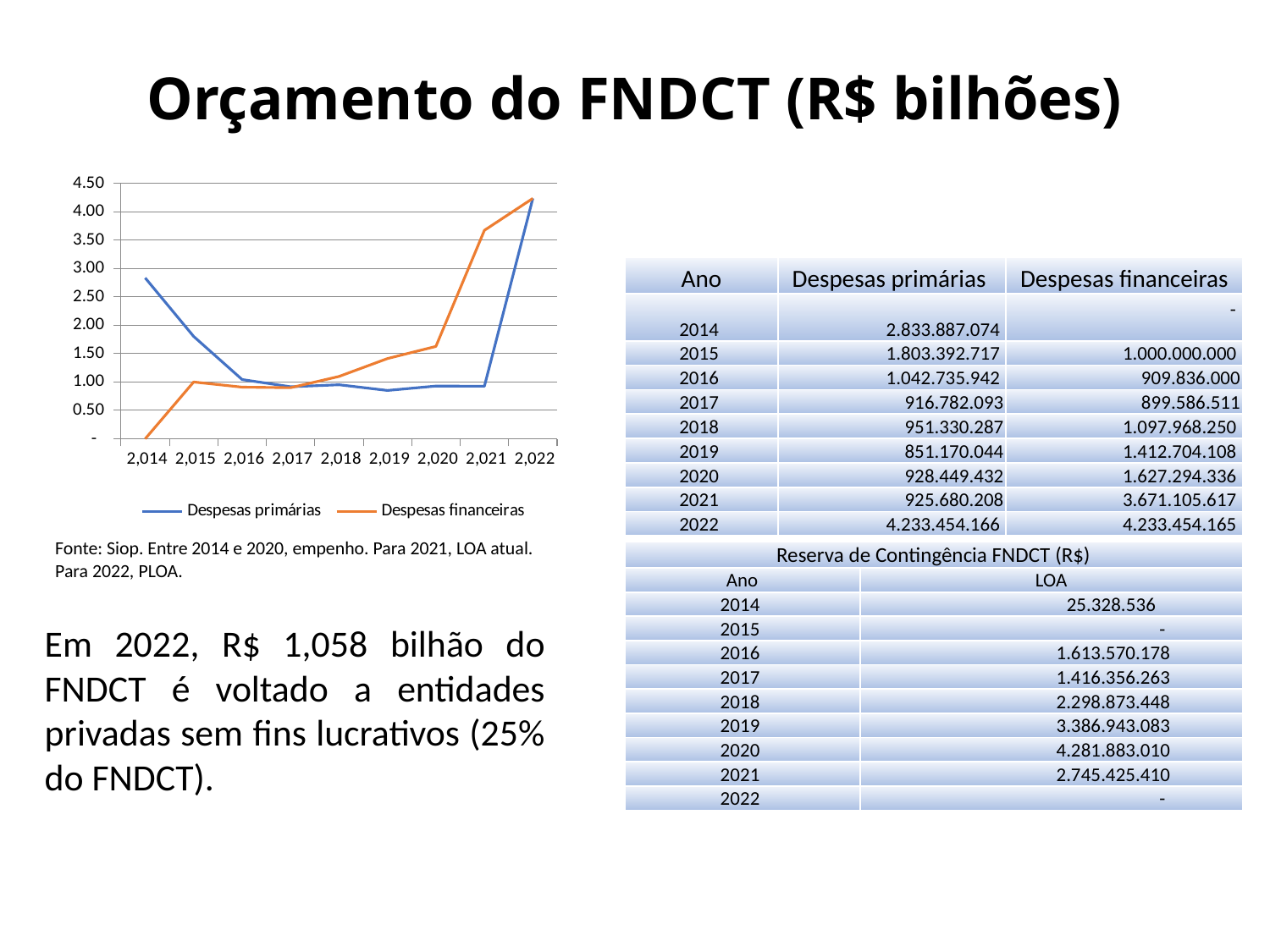
Does the Despesas financeiras series rise or fall between 2017 and 2022? rise In 2014, which series has the larger value, Despesas primárias or Despesas financeiras? Despesas primárias Is the value for Despesas primárias in 2014 greater or less than 2.50? greater In which year is the Despesas financeiras series at its lowest value? 2014 In which year does the Despesas primárias series reach its highest value? 2022 Is the value for Despesas primárias in 2019 greater or less than 1.00? less How many years are plotted along the x axis of the chart? 9 What colour is the Despesas primárias line in the chart? blue Is the value for Despesas financeiras in 2021 greater or less than 3.50? greater In 2021, which series has the larger value, Despesas primárias or Despesas financeiras? Despesas financeiras What kind of chart is shown on the slide? line chart How many series does the chart legend list? 2